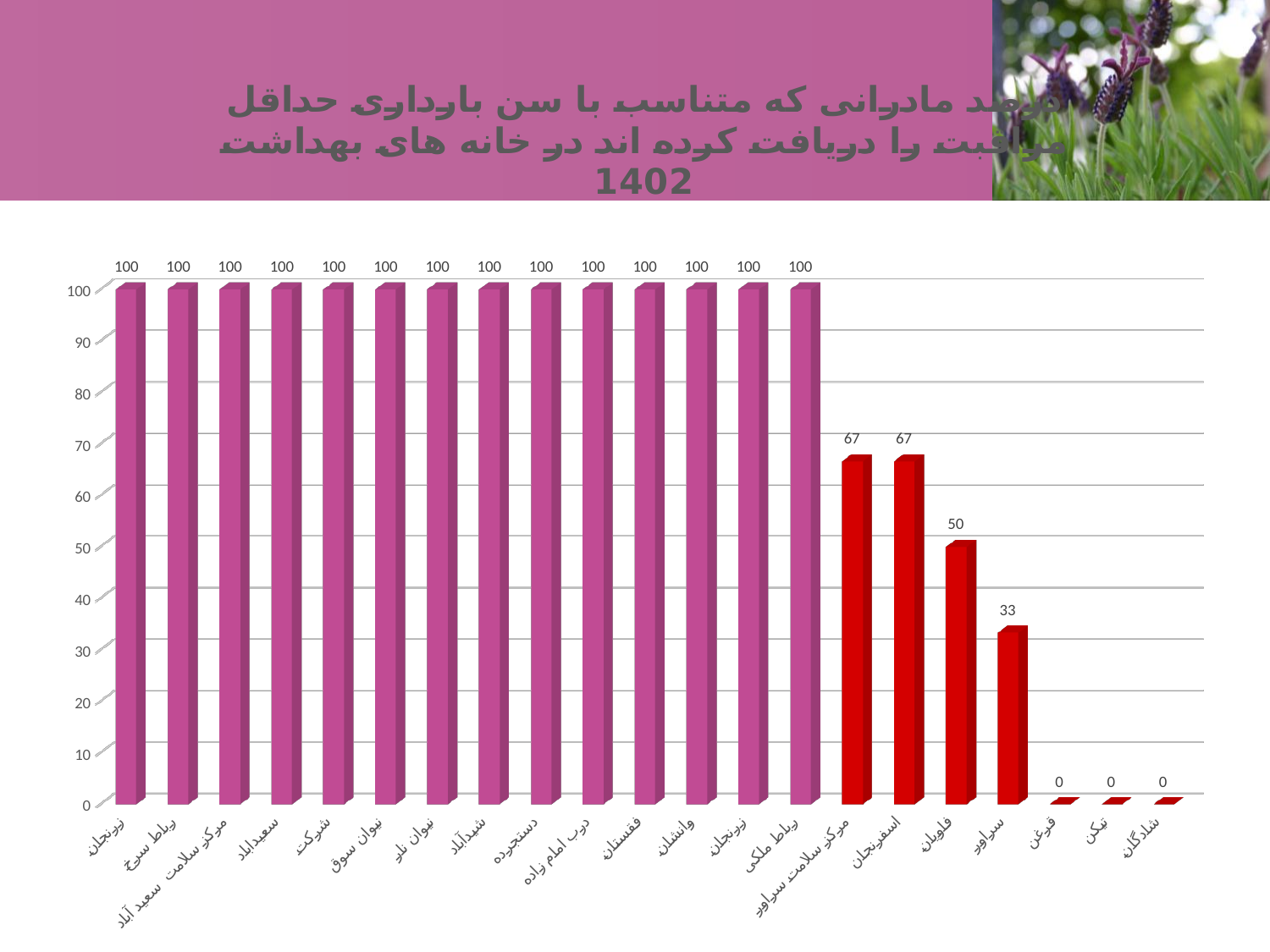
What is the value for اسفرنجان? 67 Do the values generally rise or fall from left to right along the x axis? fall What is the highest value shown on the vertical axis? 100 What is the value for تیکن? 0 How many categories (bars) are plotted in the chart? 21 How many bars have a value of 100? 14 What type of chart is shown on the slide? bar chart